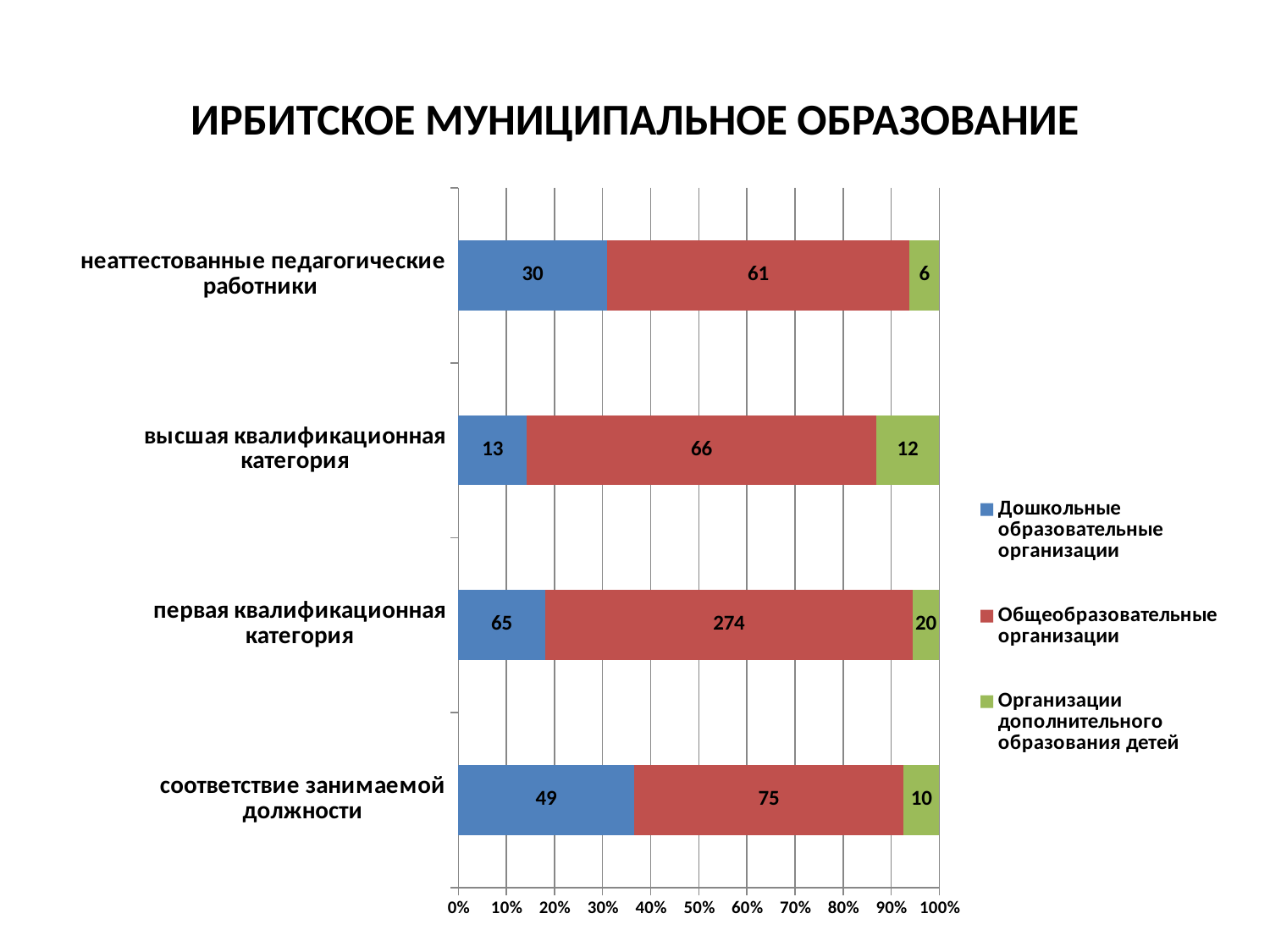
Which category has the lowest value for Организации дополнительного образования детей? неаттестованные педагогические работники What is the value for Организации дополнительного образования детей in the category 'высшая квалификационная категория'? 12 How many series does the legend list? 3 What is the total of the stacked bar for 'первая квалификационная категория'? 359 What is the title of the chart? ИРБИТСКОЕ МУНИЦИПАЛЬНОЕ ОБРАЗОВАНИЕ What is the difference between the Общеобразовательные организации values for 'соответствие занимаемой должности' and 'неаттестованные педагогические работники'? 14 Which category has the highest value for Дошкольные образовательные организации? первая квалификационная категория What kind of chart is shown on the slide? Stacked bar chart Which is larger: the Дошкольные образовательные организации value for 'неаттестованные педагогические работники' or for 'высшая квалификационная категория'? неаттестованные педагогические работники How many categories are shown on the chart? 4 What is the value for Дошкольные образовательные организации in the category 'соответствие занимаемой должности'? 49 What is the value for Общеобразовательные организации in the category 'первая квалификационная категория'? 274